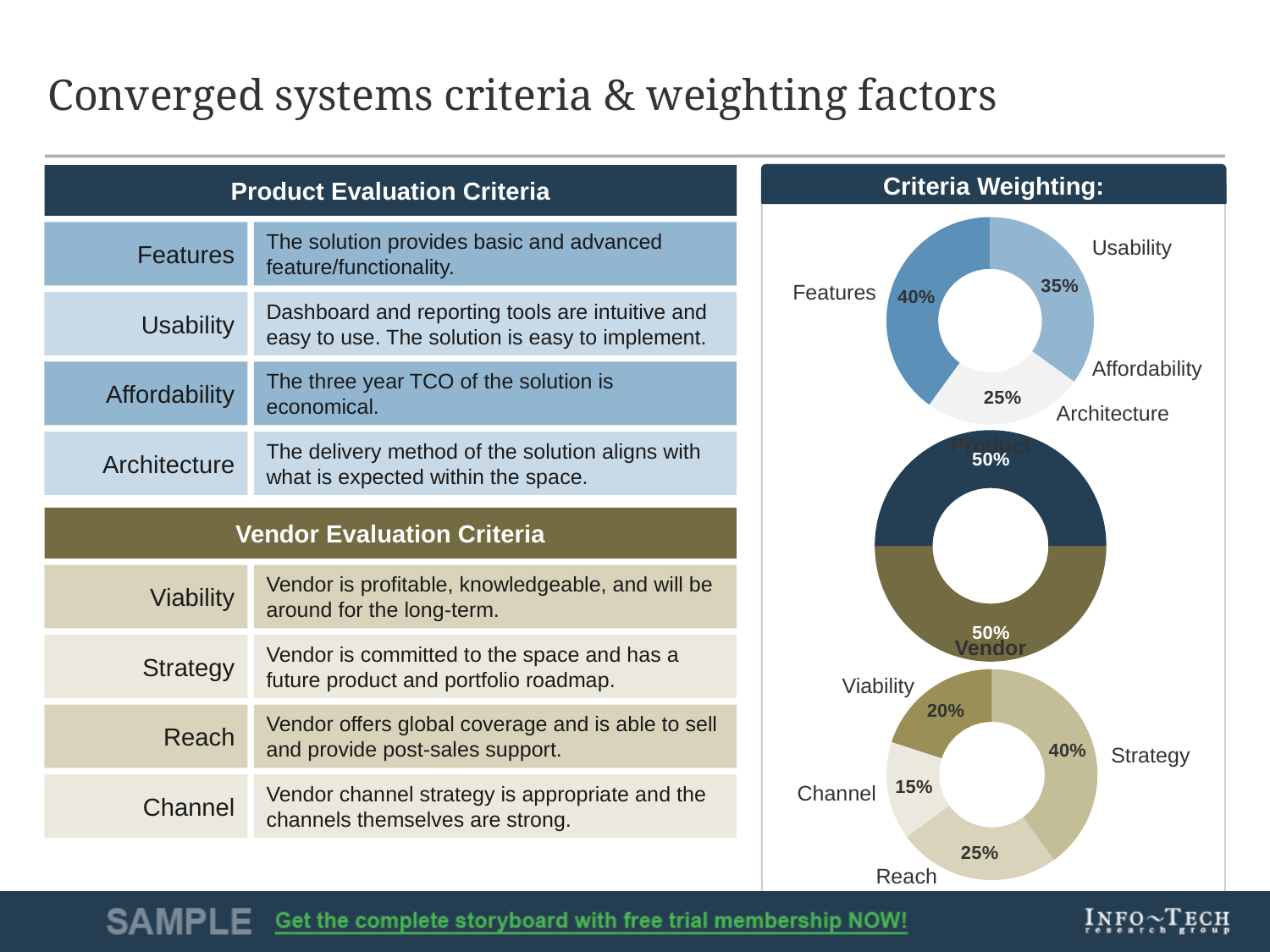
In the top donut chart under Criteria Weighting, what is the weighting for Usability? 35% In the top donut chart under Criteria Weighting, which is larger, Features or Usability? Features In the bottom donut chart, which criterion has the highest weighting? Strategy In the middle donut chart, what is the weighting for Product? 50% What kind of chart is used to show the criteria weightings on the slide? Donut chart In the top donut chart under Criteria Weighting, what is the difference between the Features and Usability weightings? 5% In the bottom donut chart, which criterion has the lowest weighting? Channel In the bottom donut chart, what is the weighting for Strategy? 40% In the bottom donut chart, what is the difference between the Reach and Viability weightings? 5% In the bottom donut chart, what is the weighting for Channel? 15% In the middle donut chart, what is the weighting for Vendor? 50% In the top donut chart under Criteria Weighting, what is the weighting for Features? 40%